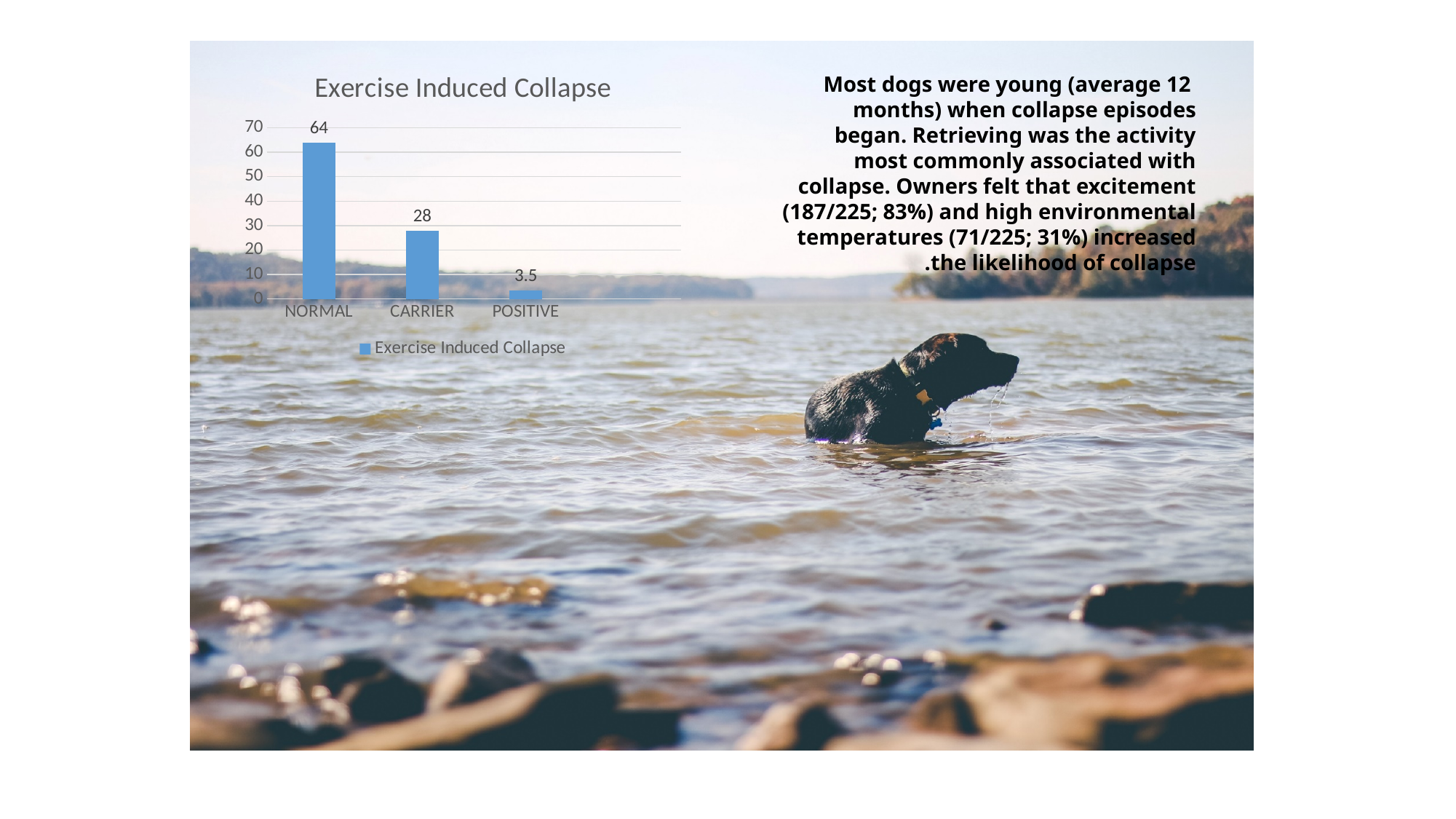
What is the value for CARRIER in the Exercise Induced Collapse chart? 28 What is the value for NORMAL in the Exercise Induced Collapse chart? 64 What is the difference between the CARRIER and POSITIVE values in the Exercise Induced Collapse chart? 24.5 What is the difference between the NORMAL and CARRIER values in the Exercise Induced Collapse chart? 36 Which category has the lowest value in the Exercise Induced Collapse chart? POSITIVE What kind of chart is the Exercise Induced Collapse chart? bar chart What is the title of the chart on the slide? Exercise Induced Collapse Which is larger in the Exercise Induced Collapse chart, CARRIER or POSITIVE? CARRIER Is the value for CARRIER greater or less than 30 in the Exercise Induced Collapse chart? less Which category has the highest value in the Exercise Induced Collapse chart? NORMAL How many categories are shown in the Exercise Induced Collapse chart? 3 What is the value for POSITIVE in the Exercise Induced Collapse chart? 3.5